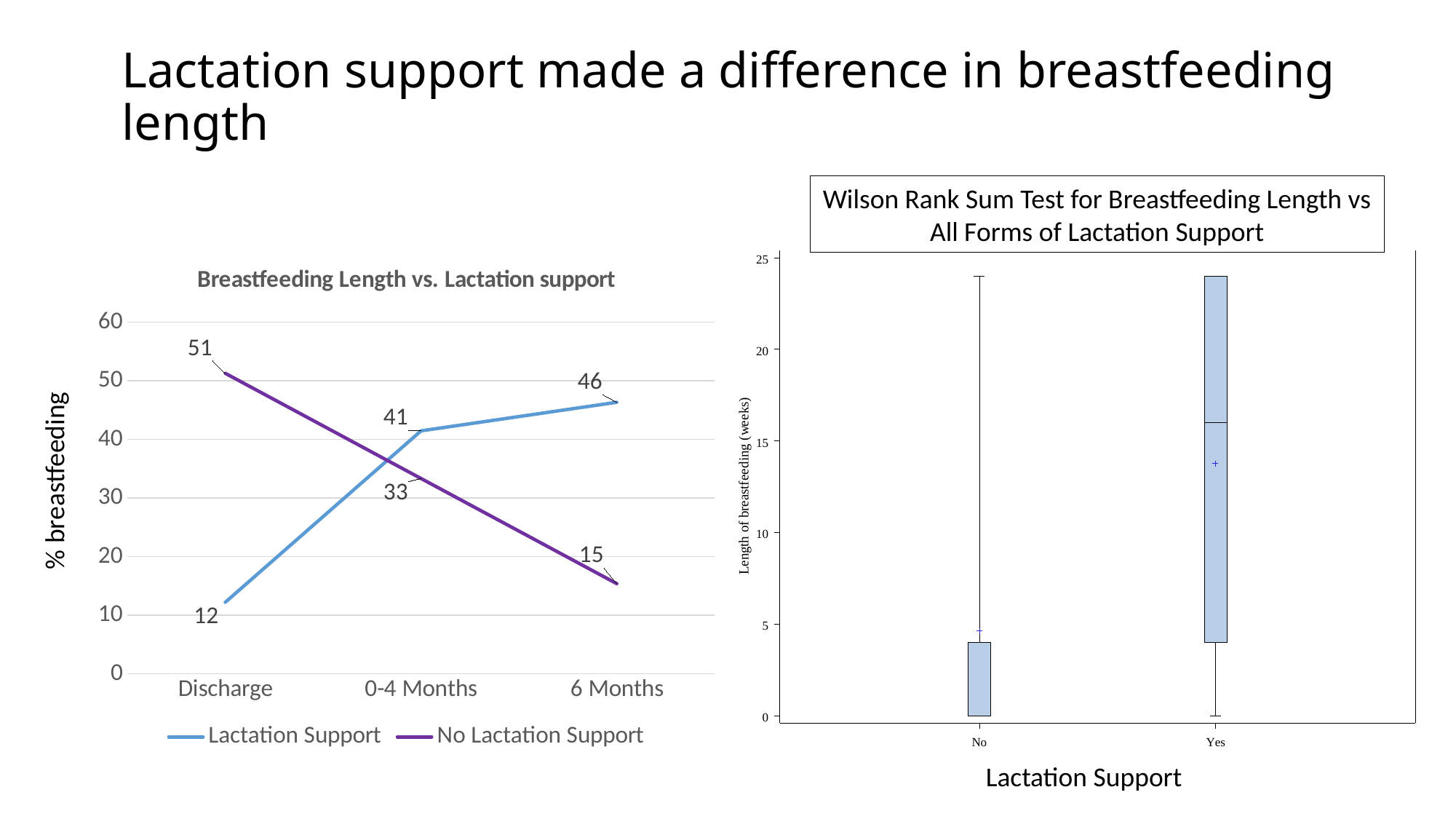
In the 'Wilson Rank Sum Test' chart on the right, is the median for the Yes group greater or less than 10 weeks? greater What kind of chart is the 'Breastfeeding Length vs. Lactation support' chart? line chart In the 'Breastfeeding Length vs. Lactation support' chart, what is the value for Lactation Support at Discharge? 12 In the 'Breastfeeding Length vs. Lactation support' chart, how many time points are shown on the x axis? 3 In the 'Breastfeeding Length vs. Lactation support' chart, at which time point is the No Lactation Support series lowest? 6 Months In the 'Breastfeeding Length vs. Lactation support' chart, what is the value for No Lactation Support at 0-4 Months? 33 In the 'Breastfeeding Length vs. Lactation support' chart, at which time point is the Lactation Support series highest? 6 Months In the 'Breastfeeding Length vs. Lactation support' chart, which series has the larger value at 0-4 Months? Lactation Support In the 'Breastfeeding Length vs. Lactation support' chart, how many series does the legend list? 2 In the 'Breastfeeding Length vs. Lactation support' chart, does the No Lactation Support series rise or fall from Discharge to 6 Months? fall In the 'Breastfeeding Length vs. Lactation support' chart, what is the difference between No Lactation Support and Lactation Support at Discharge? 39 In the 'Breastfeeding Length vs. Lactation support' chart, what is the value for No Lactation Support at 6 Months? 15